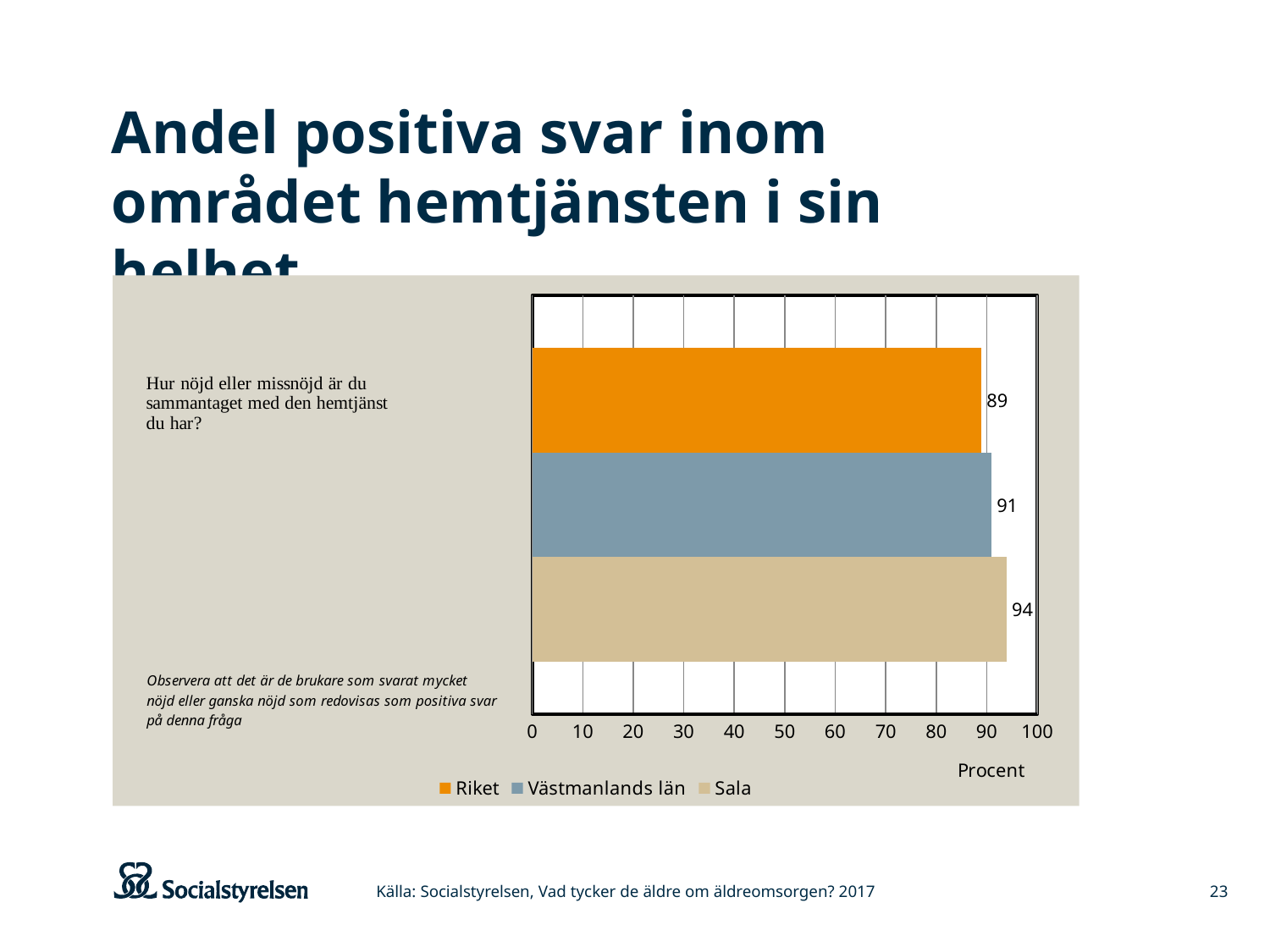
How many series does the legend list? 3 Which series has the lowest value? Riket What is the label of the horizontal axis? Procent Is the value for Riket greater or less than 90? less What is the value for Västmanlands län? 91 Which series has the highest value? Sala What is the difference between the values for Västmanlands län and Riket? 2 What is the difference between the values for Sala and Riket? 5 What is the value for Sala? 94 What kind of chart is shown on the slide? bar chart Which is larger, the value for Sala or the value for Västmanlands län? Sala What is the value for Riket? 89